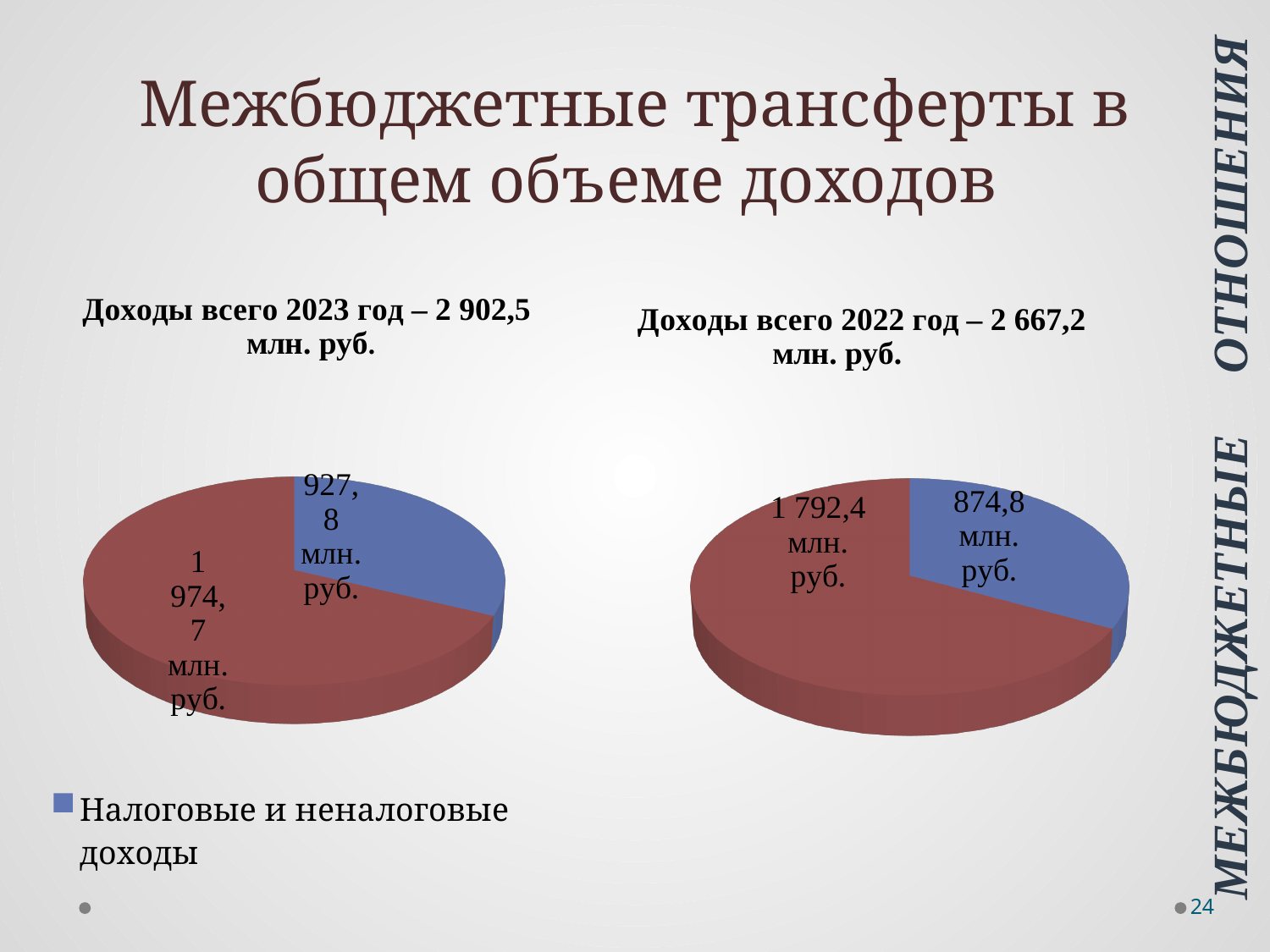
What kind of chart is used on this slide for the 2023 and 2022 income data? Pie chart What is the only entry shown in the legend below the charts? Налоговые и неналоговые доходы In the left chart (2023), what is the difference between the red slice and the Налоговые и неналоговые доходы slice? 1 046,9 млн. руб. In the chart titled "Доходы всего 2022 год – 2 667,2 млн. руб.", what is the value for Налоговые и неналоговые доходы? 874,8 млн. руб. In the left chart (2023), which slice is larger, the blue one (Налоговые и неналоговые доходы) or the red one? The red one In the left chart (2023), what is the value of the red slice? 1 974,7 млн. руб. In the right chart (2022), what is the difference between the red slice and the Налоговые и неналоговые доходы slice? 917,6 млн. руб. How many slices does the left chart (2023) have? 2 What is the total of the two slices in the right chart (2022)? 2 667,2 млн. руб. In the chart titled "Доходы всего 2023 год – 2 902,5 млн. руб.", what is the value for Налоговые и неналоговые доходы? 927,8 млн. руб. Which year has the larger value for Налоговые и неналоговые доходы, 2023 (left chart) or 2022 (right chart)? 2023 In the right chart (2022), what is the value of the red slice? 1 792,4 млн. руб.